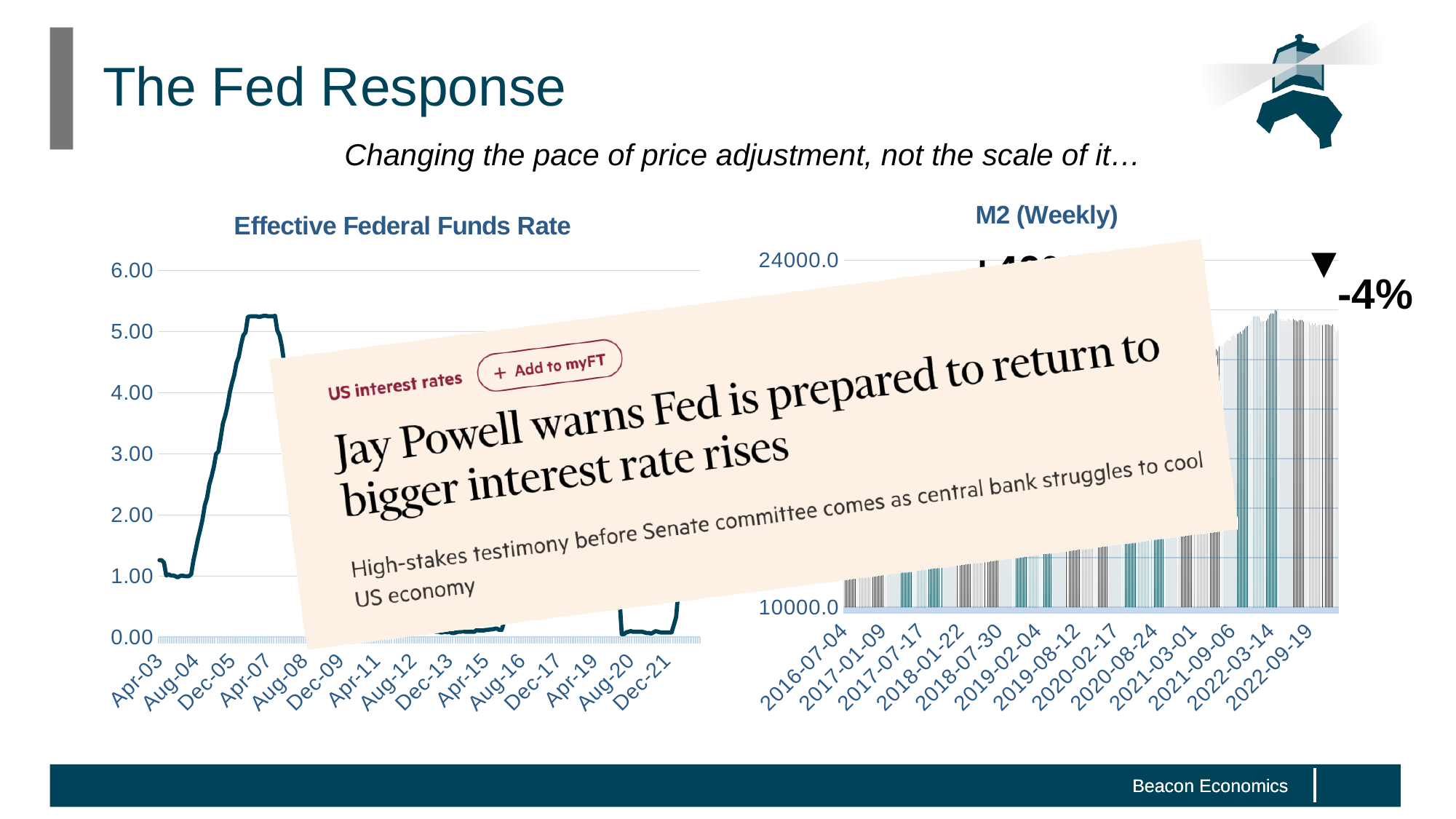
In the Effective Federal Funds Rate chart, does the line rise or fall between Aug-04 and Apr-07? rise In the Effective Federal Funds Rate chart, does the line rise or fall immediately after its peak around Apr-07? fall What kind of chart is the Effective Federal Funds Rate chart on the left? line chart What is the title of the chart on the left of the slide? Effective Federal Funds Rate What kind of chart is the M2 (Weekly) chart on the right? bar chart In the Effective Federal Funds Rate chart, is the value at Dec-21 greater or less than 1.00? less In the M2 (Weekly) chart, are the bars at 2022-09-19 greater or less than 10000.0? greater In the Effective Federal Funds Rate chart, is the peak value around Apr-07 greater or less than 5.00? greater What percentage change is annotated next to the down arrow on the M2 (Weekly) chart? -4%